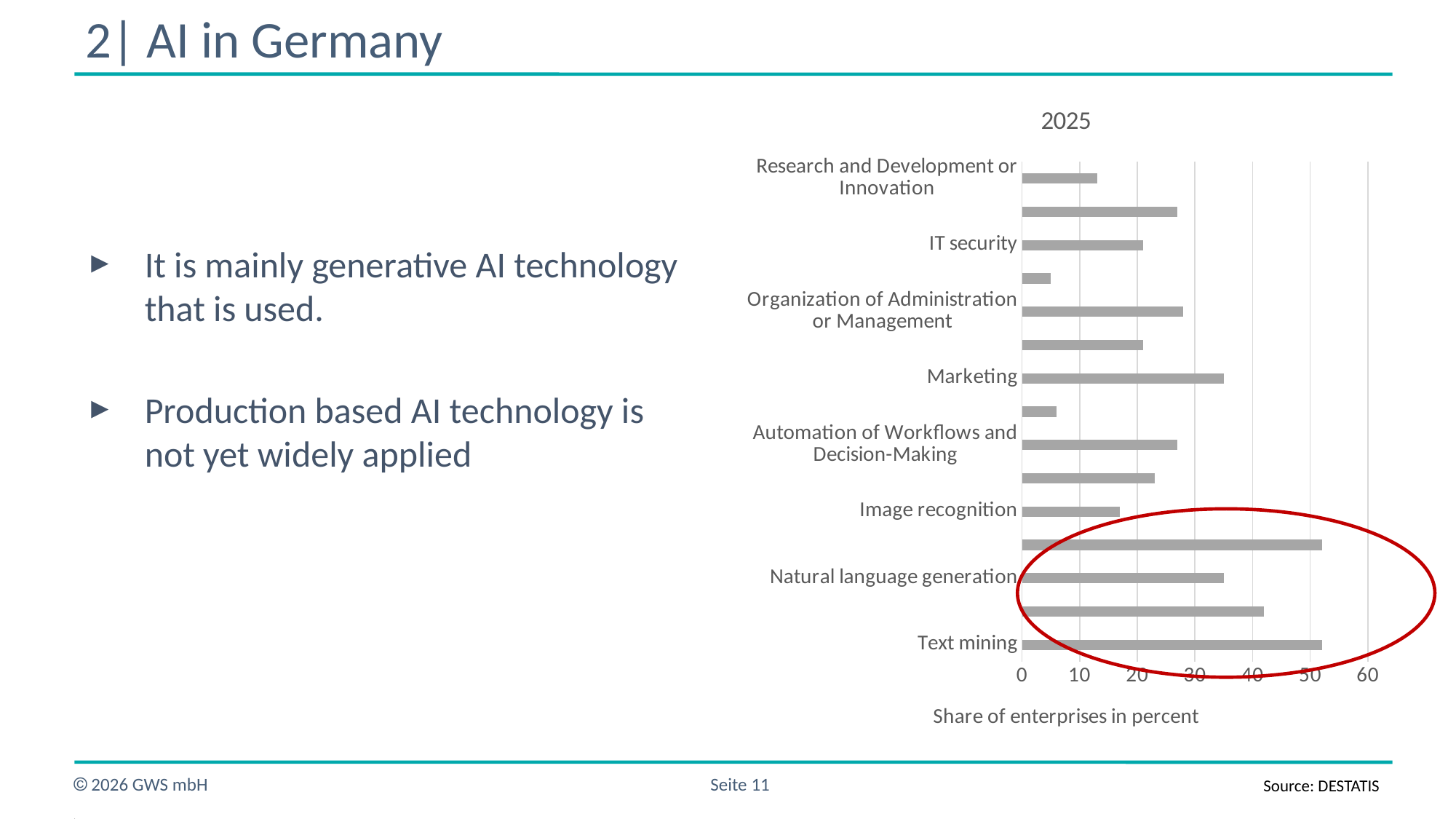
What is the title of the chart? 2025 Is the value for Image recognition greater or less than 20? less What kind of chart is shown on the slide? bar chart Is the value for Automation of Workflows and Decision-Making greater or less than 20? greater Is the value for Natural language generation greater or less than 30? greater What is the label of the horizontal axis of the chart? Share of enterprises in percent Which has the larger value, Marketing or Image recognition? Marketing Which has the larger value, Text mining or Research and Development or Innovation? Text mining